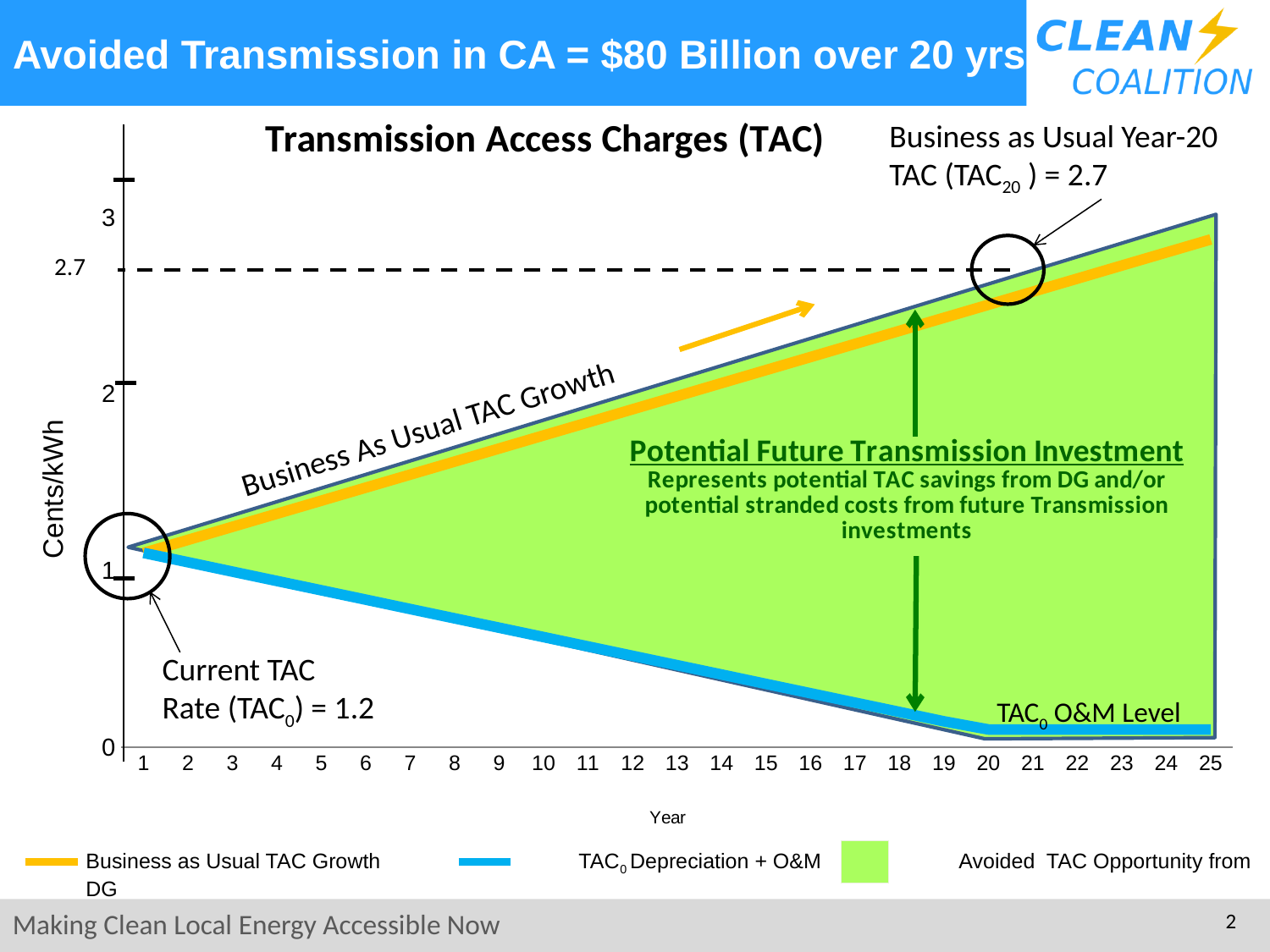
Is the Business as Usual TAC Growth value at year 5 greater or less than 2? less Is the TAC0 Depreciation + O&M value at year 15 greater or less than 1? less Does the Business as Usual TAC Growth line rise or fall as the year increases? rise Is the Business as Usual TAC Growth value at year 15 greater or less than 2? greater Does the TAC0 Depreciation + O&M line rise or fall as the year increases? fall What is the Business as Usual Year-20 TAC (TAC20) shown on the chart? 2.7 How many series does the chart legend list? 3 How many years are shown on the x axis of the chart? 25 What is the Current TAC Rate (TAC0) shown on the chart? 1.2 What kind of chart is shown on the slide? line chart What is the difference between the Business as Usual Year-20 TAC and the Current TAC Rate? 1.5 What is the title of the chart? Transmission Access Charges (TAC)